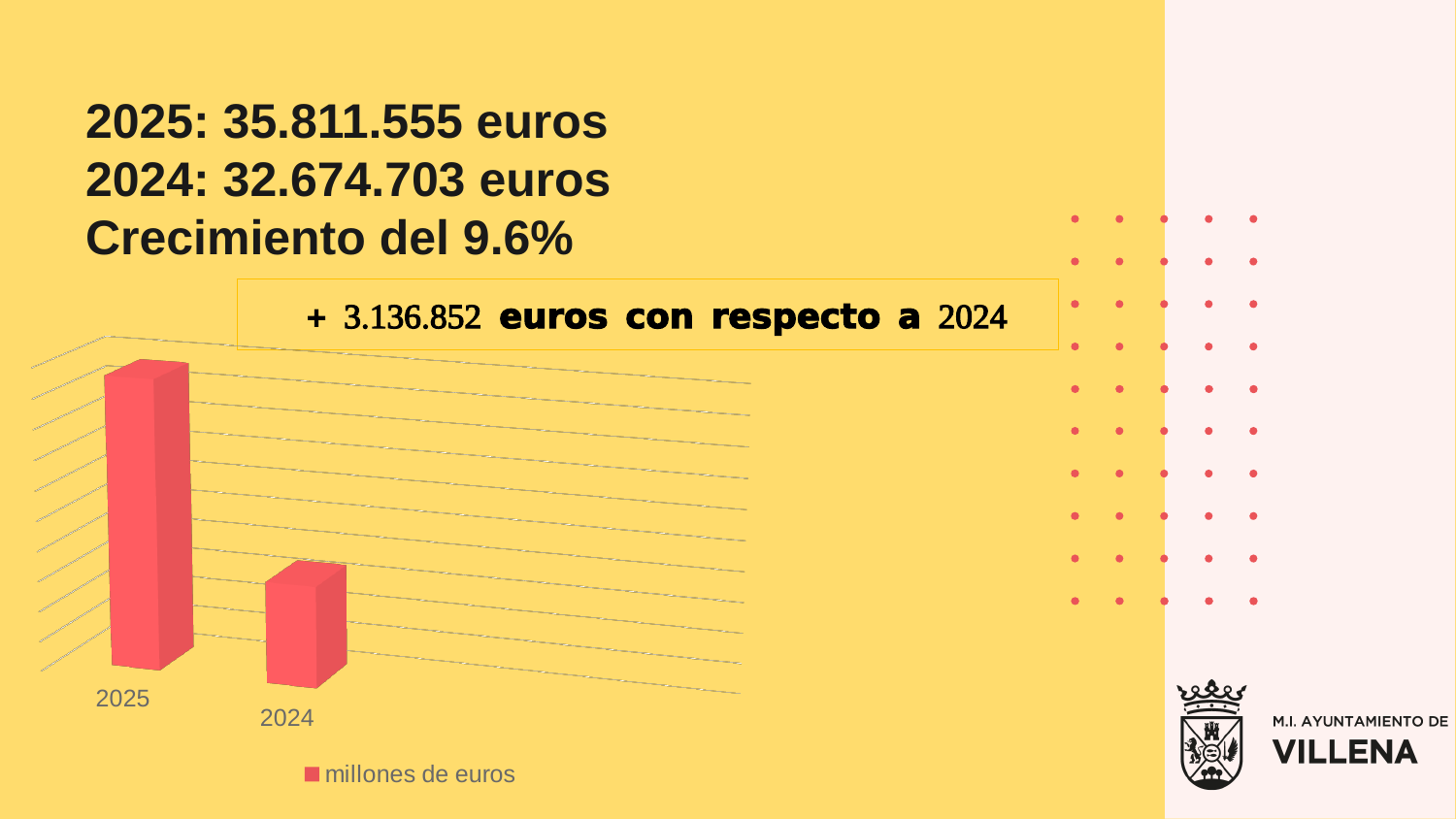
What is the legend entry of the chart? millones de euros How many bars does the chart show? 2 Which bar is taller, 2025 or 2024? 2025 Do the bar heights rise or fall from left to right along the x axis? fall How many series does the legend list? 1 What kind of chart is shown on the slide? bar chart What colour are the bars in the chart? red Which year has the shortest bar in the chart? 2024 Which year has the tallest bar in the chart? 2025